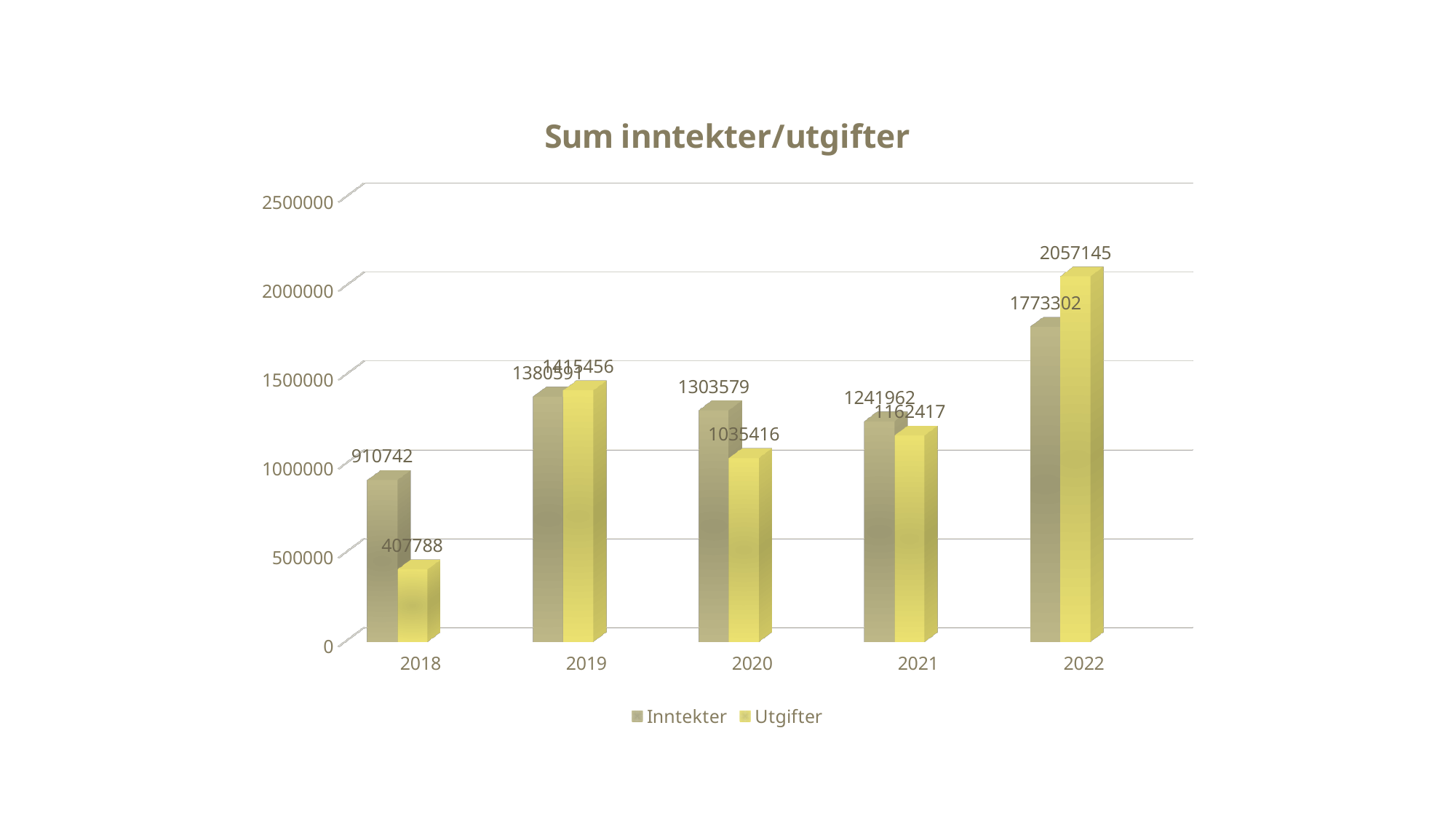
What is the Inntekter value for 2018? 910742 What kind of chart is shown on the slide? bar chart Is the Inntekter value for 2019 greater or less than 1500000? less What is the Utgifter value for 2022? 2057145 In which year is Utgifter lowest? 2018 How many years are shown on the x axis? 5 What is the Utgifter value for 2020? 1035416 How many series does the legend list? 2 In 2020, which is larger, Inntekter or Utgifter? Inntekter What is the difference between Utgifter and Inntekter in 2022? 283843 In which year is Utgifter highest? 2022 What is the difference between Inntekter and Utgifter in 2018? 502954